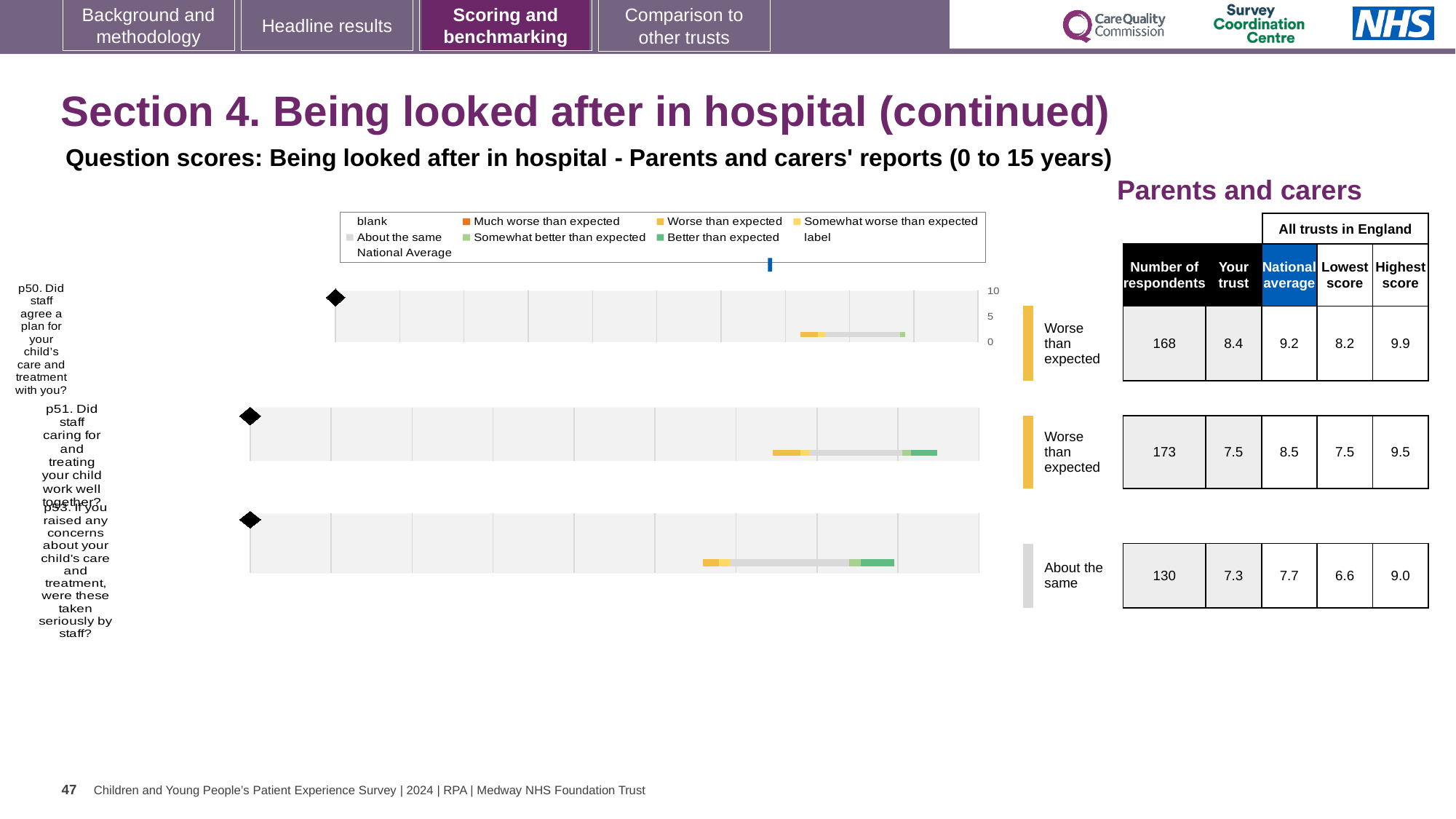
For p51, which is larger: the 'Your trust' score or the national average? National average Which question has the lowest 'Your trust' score? p53 What is the 'Your trust' score for p50 (Did staff agree a plan for your child's care and treatment with you)? 8.4 What is the highest score among all trusts in England for p51? 9.5 What kind of chart is used to show the question scores on this slide? bar chart How many respondents are there for p53 (If you raised any concerns about your child's care and treatment, were these taken seriously by staff)? 130 What is the national average score for p51 (Did staff caring for and treating your child work well together)? 8.5 What benchmark category is shown for p53? About the same For p50, what is the difference between the national average and the 'Your trust' score? 0.8 How many questions (p50, p51, p53) are plotted on the slide? 3 For p53, what is the difference between the highest score and the lowest score among all trusts in England? 2.4 Which question has the highest 'Your trust' score? p50